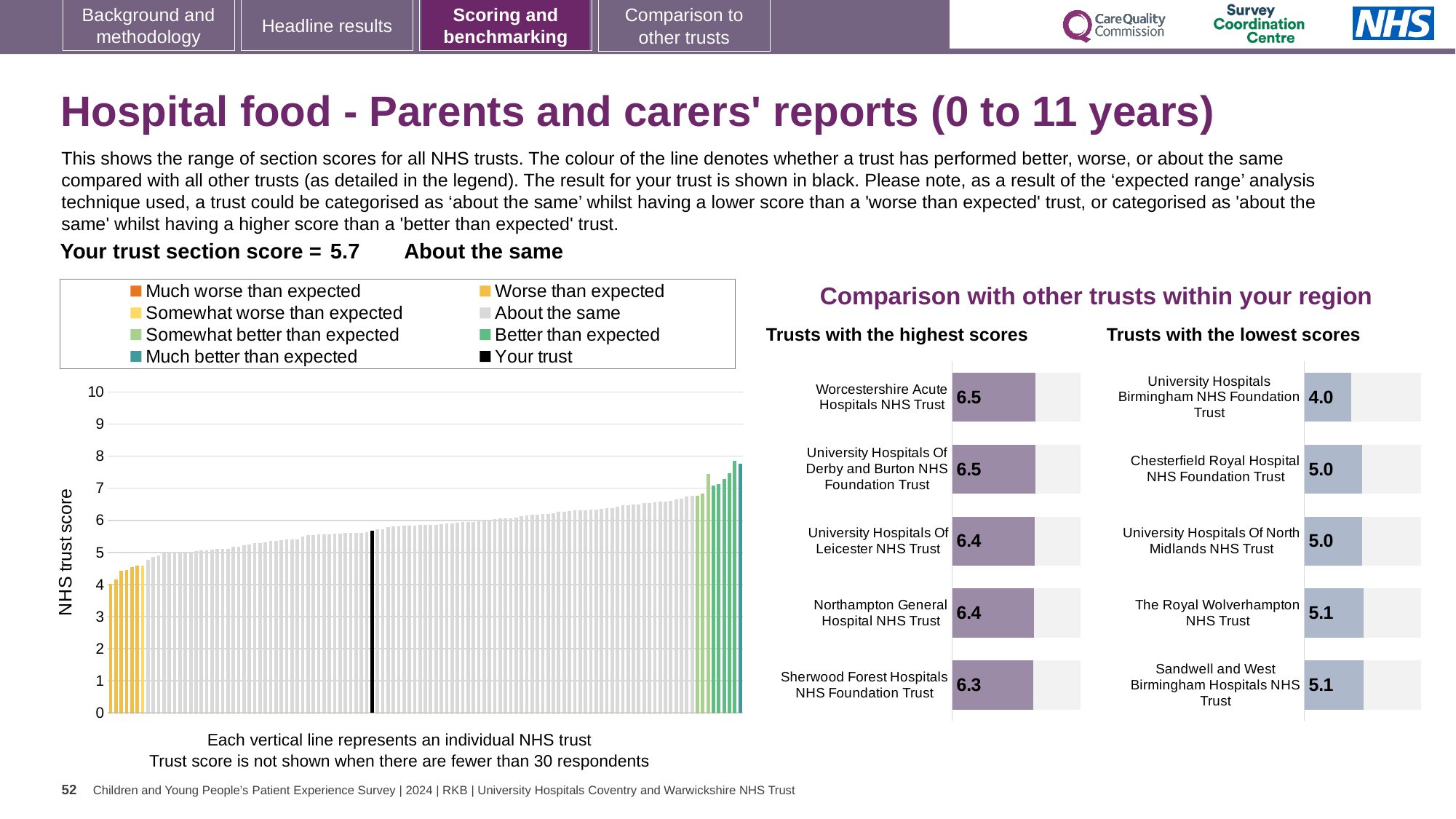
How many trusts are shown in the 'Trusts with the highest scores' chart? 5 What kind of chart is the large chart on the left showing NHS trust scores? Bar chart In the 'Trusts with the highest scores' chart, which has the higher score: Northampton General Hospital NHS Trust or Sherwood Forest Hospitals NHS Foundation Trust? Northampton General Hospital NHS Trust In the 'Trusts with the lowest scores' chart, what is the score for University Hospitals Birmingham NHS Foundation Trust? 4.0 In the large chart on the left, is the value of the tallest bar greater or less than 7? greater In the 'Trusts with the highest scores' chart, what is the score for Worcestershire Acute Hospitals NHS Trust? 6.5 In the 'Trusts with the lowest scores' chart, which trust has the lowest score? University Hospitals Birmingham NHS Foundation Trust How many entries does the legend above the large chart on the left list? 8 In the large chart on the left, what is the section score of the trust shown in black (your trust)? 5.7 In the 'Trusts with the highest scores' chart, what is the difference between the scores of Worcestershire Acute Hospitals NHS Trust and Sherwood Forest Hospitals NHS Foundation Trust? 0.2 In the 'Trusts with the lowest scores' chart, what is the difference between the scores of Chesterfield Royal Hospital NHS Foundation Trust and University Hospitals Birmingham NHS Foundation Trust? 1.0 In the large chart on the left, do the trust scores rise or fall from left to right? Rise